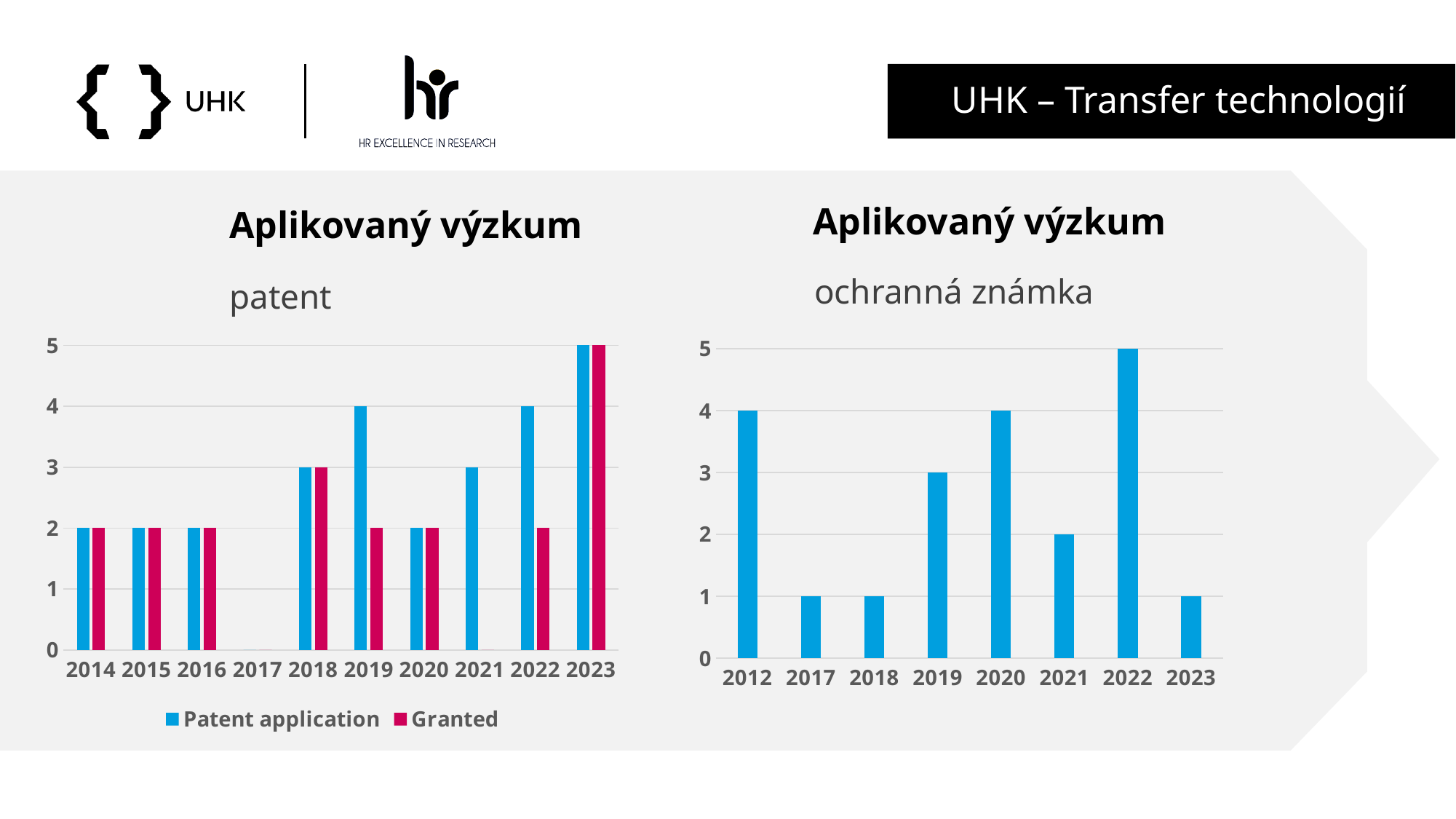
In the left chart (patent), which year has the highest Patent application value? 2023 In the right chart (ochranná známka), which year has the highest value? 2022 In the left chart (patent), how many years are shown on the x axis? 10 In the left chart (patent), what is the value of Granted for 2022? 2 In the left chart (patent), what is the value of Patent application for 2019? 4 In the left chart (patent), how many series does the legend list? 2 What kind of chart is the right chart (ochranná známka)? Bar chart In the right chart (ochranná známka), what is the difference between the values for 2022 and 2023? 4 In the right chart (ochranná známka), how many years are shown on the x axis? 8 In the right chart (ochranná známka), what is the value for 2020? 4 In the left chart (patent), what is the difference between Patent application and Granted in 2019? 2 In the left chart (patent), which is larger in 2021: Patent application or Granted? Patent application